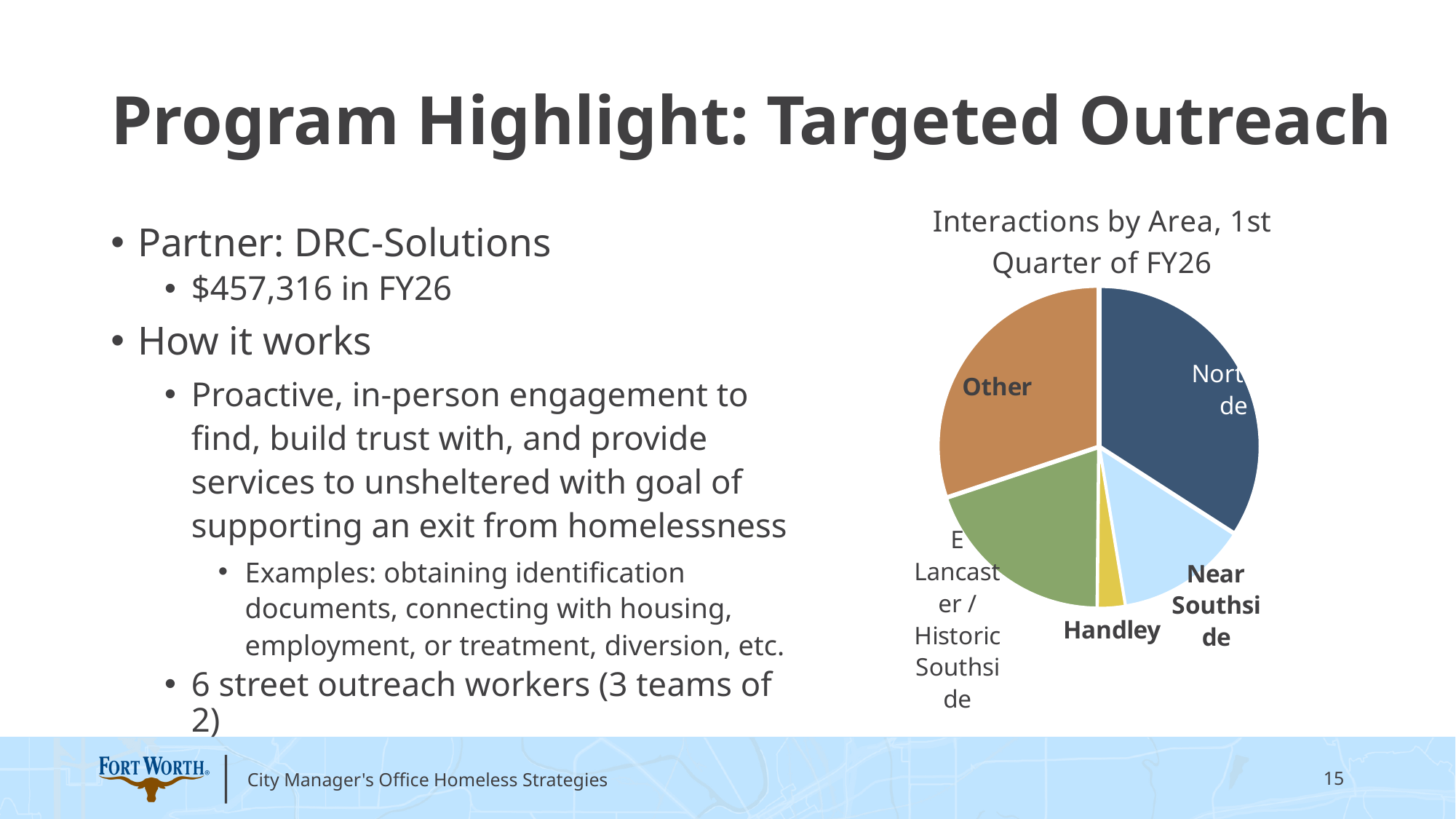
What colour is the Other slice in the pie chart? orange Which area has the smallest slice in the pie chart? Handley Which slice is larger, E Lancaster / Historic Southside or Handley? E Lancaster / Historic Southside Which slice is larger, Handley or Near Southside? Near Southside What kind of chart is shown on the slide? pie chart How many slices does the pie chart have? 5 Which slice is larger, Other or Near Southside? Other What is the title of the pie chart? Interactions by Area, 1st Quarter of FY26